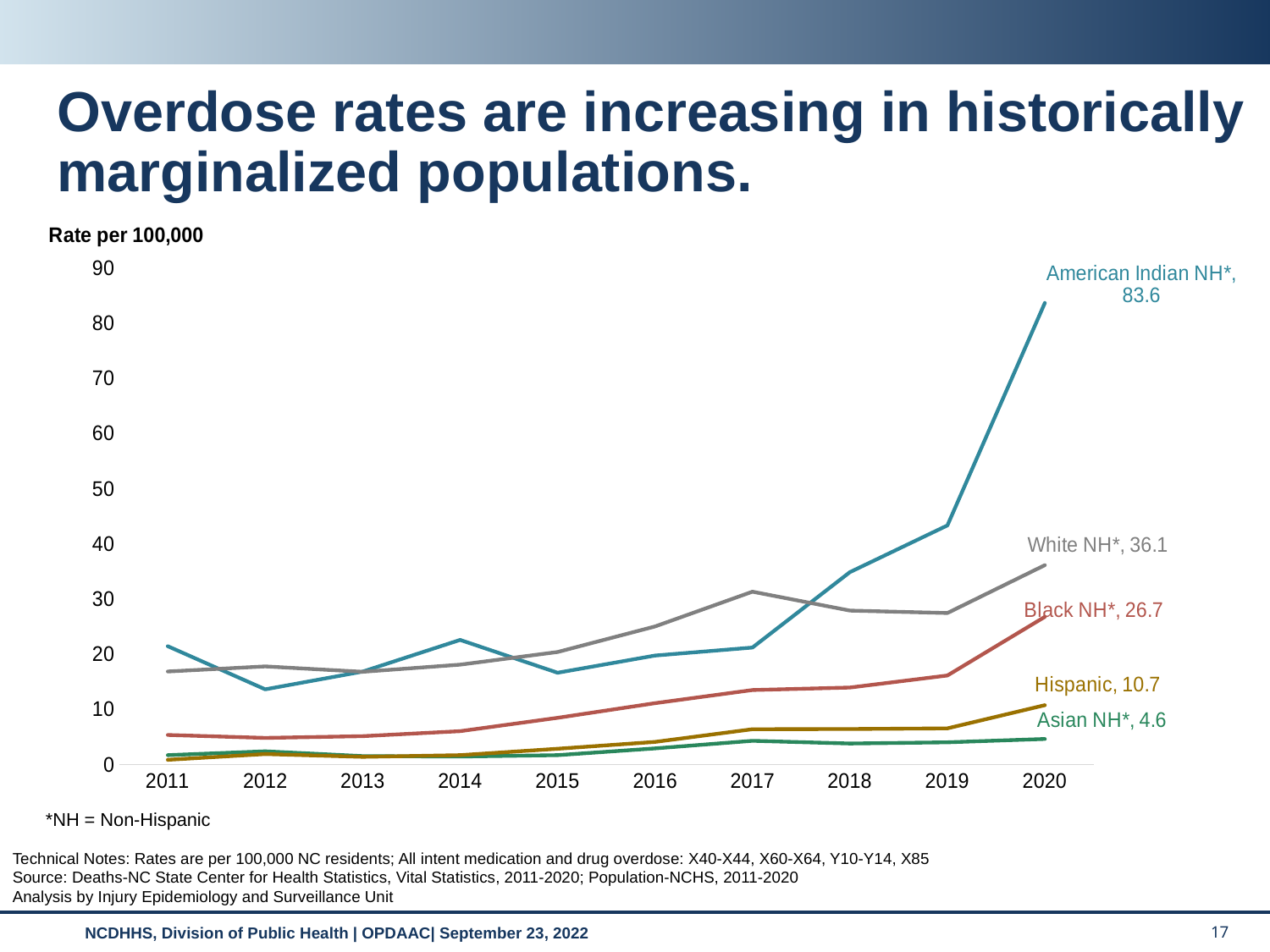
Which population has the lowest overdose rate in 2020? Asian NH* Is the American Indian NH* rate in 2019 greater or less than 40? greater What type of chart is shown on the slide? line chart What is the difference between the 2020 rates for American Indian NH* and White NH*? 47.5 Is the 2020 rate for Black NH* or Hispanic larger? Black NH* What is the 2020 overdose rate for White NH*? 36.1 How many years are shown on the x axis? 10 What is the 2020 overdose rate for Asian NH*? 4.6 What is the 2020 overdose rate for American Indian NH*? 83.6 Which population has the highest overdose rate in 2020? American Indian NH* What is the 2020 overdose rate for Hispanic? 10.7 What is the 2020 overdose rate for Black NH*? 26.7